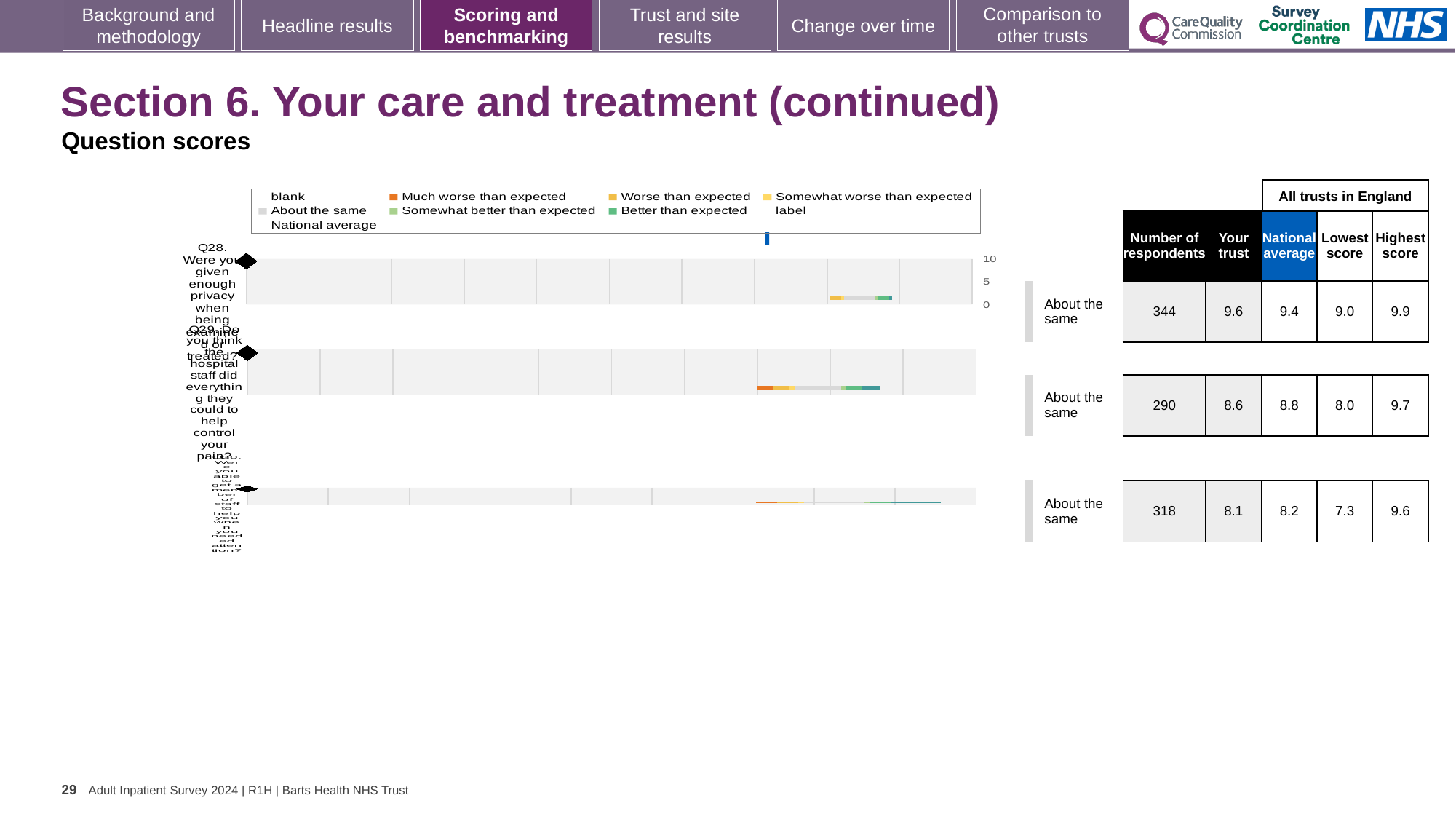
For Q29, which is larger: the 'Your trust' score or the national average? National average What is the maximum value shown on the chart's score axis? 10 In the table beside the chart, what is the 'Your trust' score for Q28 (privacy when being examined or treated)? 9.6 For Q28, what is the difference between the highest score and the lowest score across all trusts in England? 0.9 How many questions (rows) are plotted in the chart? 3 In the table beside the chart, what is the national average for Q29 (staff did everything to help control pain)? 8.8 What benchmark category is shown for Q30? About the same In the table beside the chart, how many respondents are listed for Q30 (able to get a member of staff to help when needed)? 318 Which question has the lowest 'Lowest score' value in the table? Q30 Which question has the highest 'Your trust' score in the table? Q28 How many more respondents answered Q28 than Q29? 54 What kind of chart is shown on the slide? bar chart